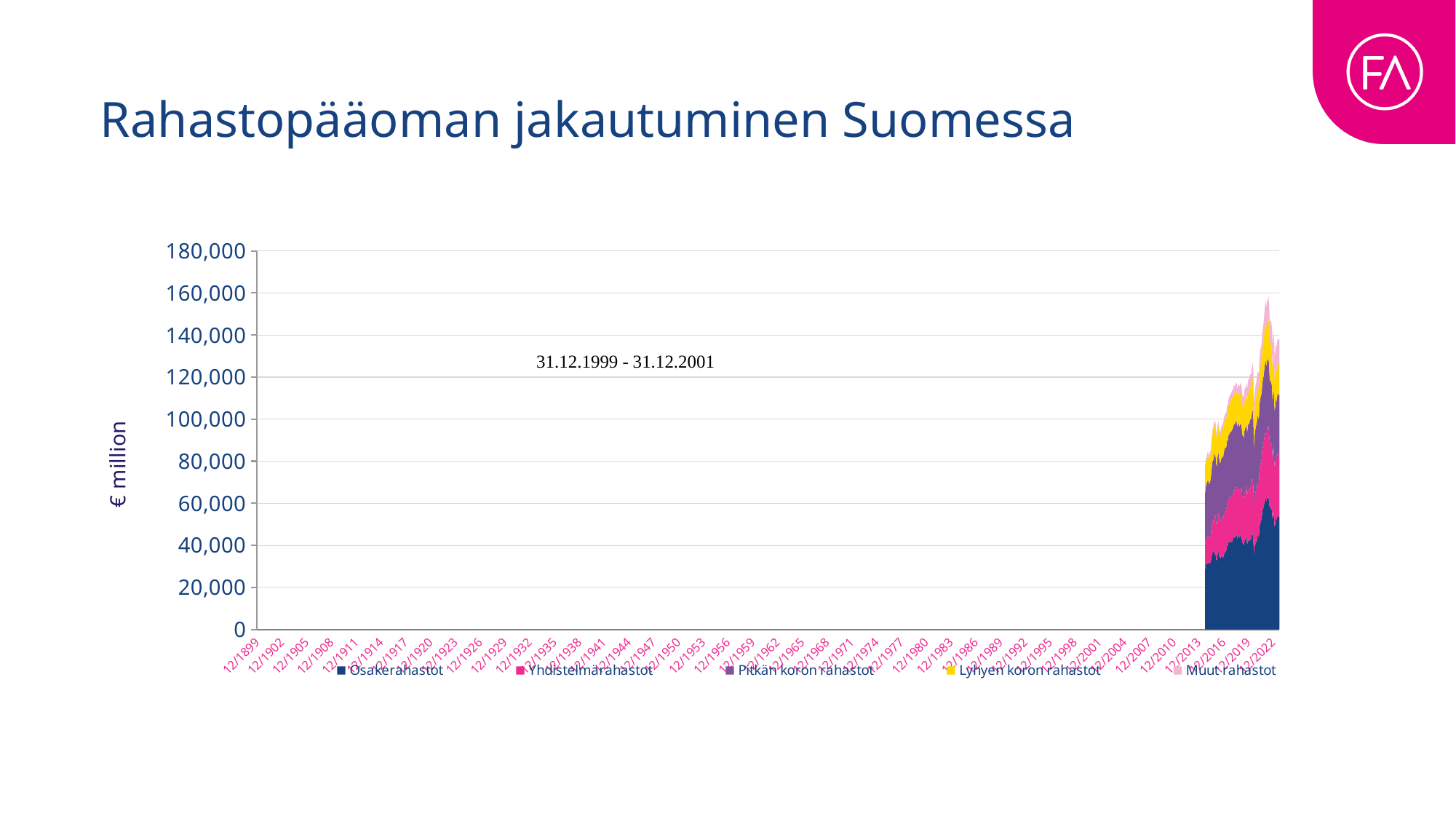
How many series does the legend list? 5 Is the peak total value of the stacked areas greater or less than 140,000? greater What is the title of the chart? Rahastopääoman jakautuminen Suomessa What is the label on the vertical axis? € million Does the total fund capital generally rise or fall between 12/2013 and 12/2022? rise What kind of chart is shown on the slide? Stacked area chart Is the total value of the stacked areas at 12/2022 greater or less than 100,000? greater Is the value for Osakerahastot at 12/2022 greater or less than 40,000? greater Which series is plotted at the bottom of the stack? Osakerahastot